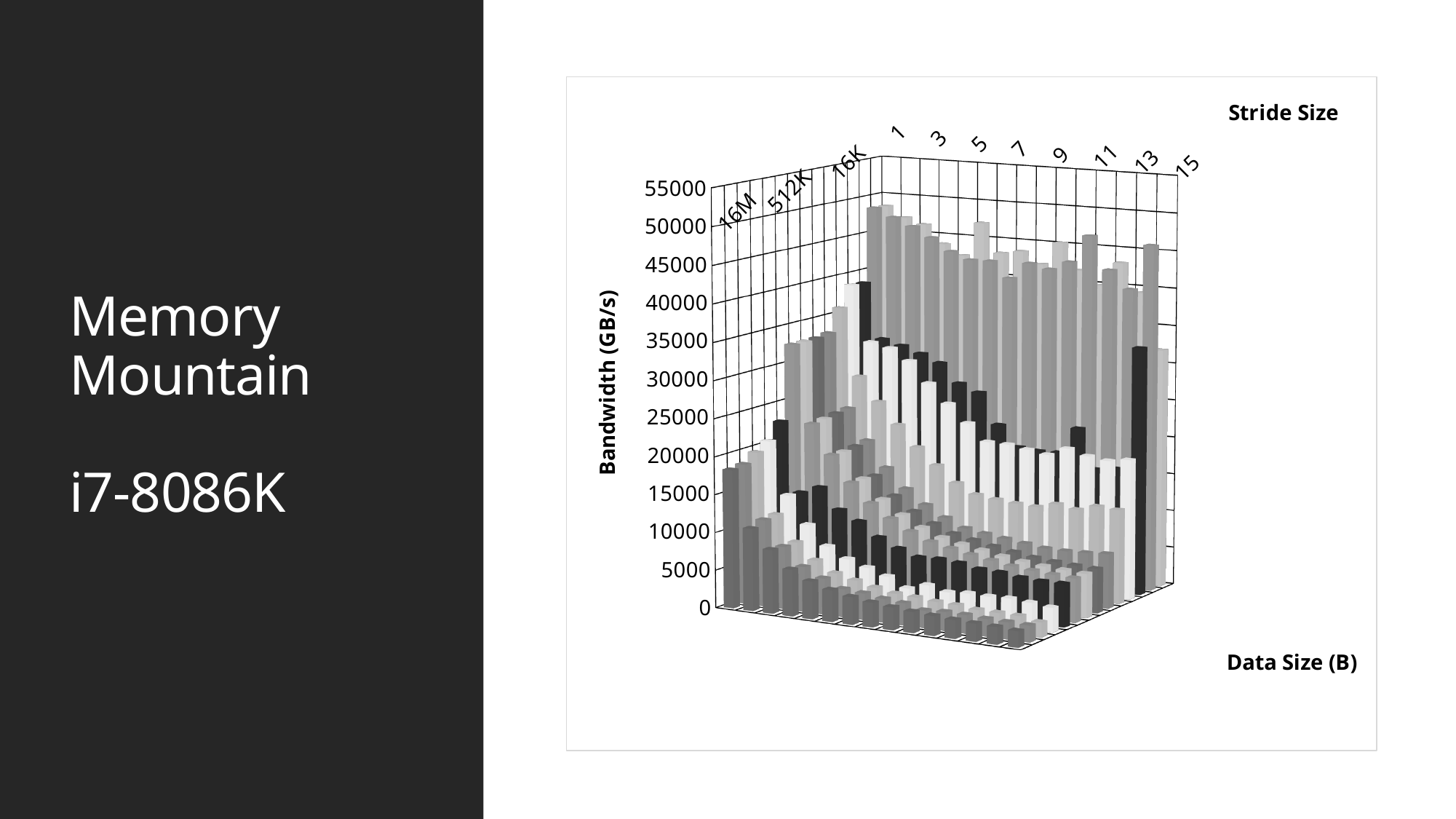
What kind of chart is shown on the slide? 3D bar chart What is the label of the vertical axis of the chart? Bandwidth (GB/s) What is the highest tick value shown on the Bandwidth (GB/s) axis? 55000 Does bandwidth generally rise or fall as the data size increases from 16K toward 16M? fall How many stride size labels are shown along the Stride Size axis? 8